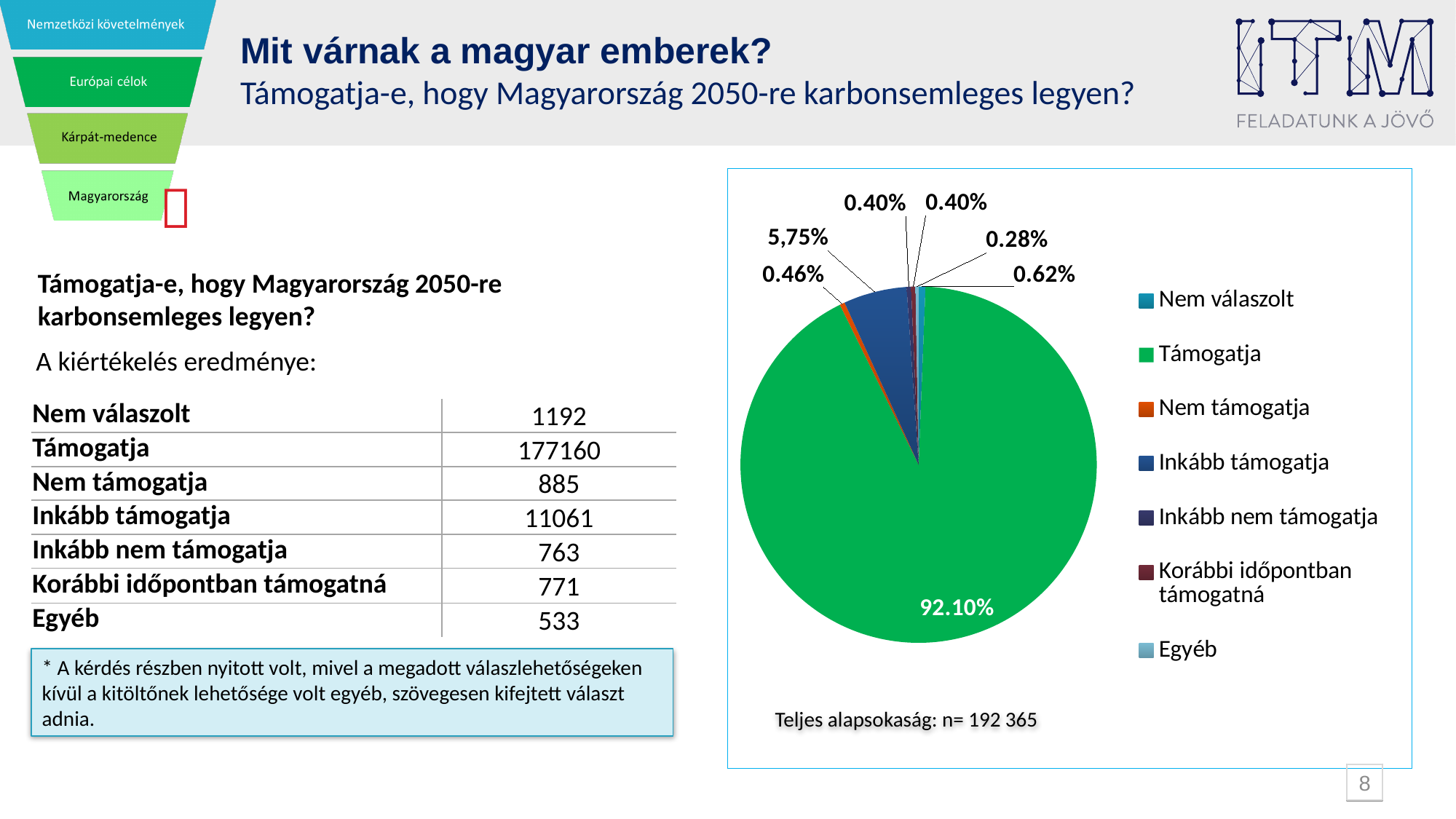
What colour is the 'Támogatja' slice in the pie chart? green What total population (n) is stated below the pie chart? 192 365 Which category has the smallest slice in the pie chart? Egyéb How many slices does the pie chart have? 7 What share of the pie does the 'Támogatja' slice represent? 92.10% What percentage is shown for the 'Nem támogatja' slice? 0.46% Which slice is larger, 'Inkább támogatja' or 'Nem támogatja'? Inkább támogatja How many entries does the legend of the pie chart list? 7 Which category has the largest slice in the pie chart? Támogatja What percentage is shown for the 'Inkább támogatja' slice? 5,75% What kind of chart is shown on the slide? pie chart What is the difference in percentage points between the 'Támogatja' slice and the 'Inkább támogatja' slice? 86.35%